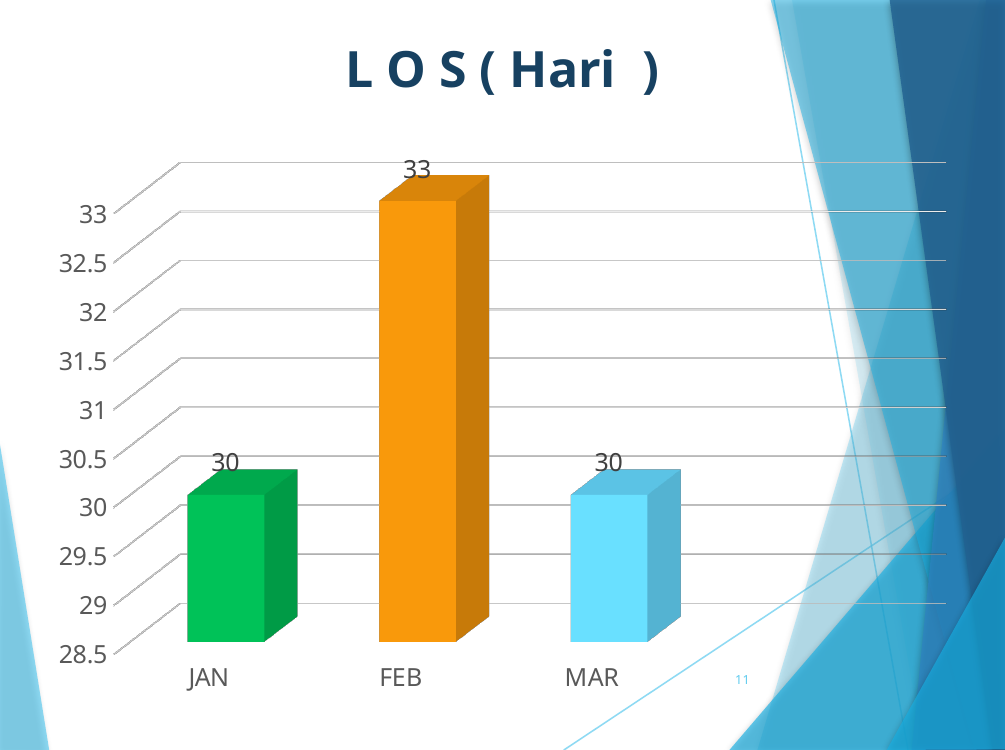
What is the value for JAN? 30 What colour is the bar for FEB? orange Which is larger, the value for FEB or the value for MAR? FEB Which month has the highest value? FEB What is the title of the chart? L O S ( Hari ) Is the value for JAN greater or less than 31? less How many months are shown on the x axis? 3 What is the value for FEB? 33 What is the difference between the values for FEB and JAN? 3 Is the value for FEB greater or less than 32? greater What kind of chart is shown on the slide? bar chart What is the value for MAR? 30